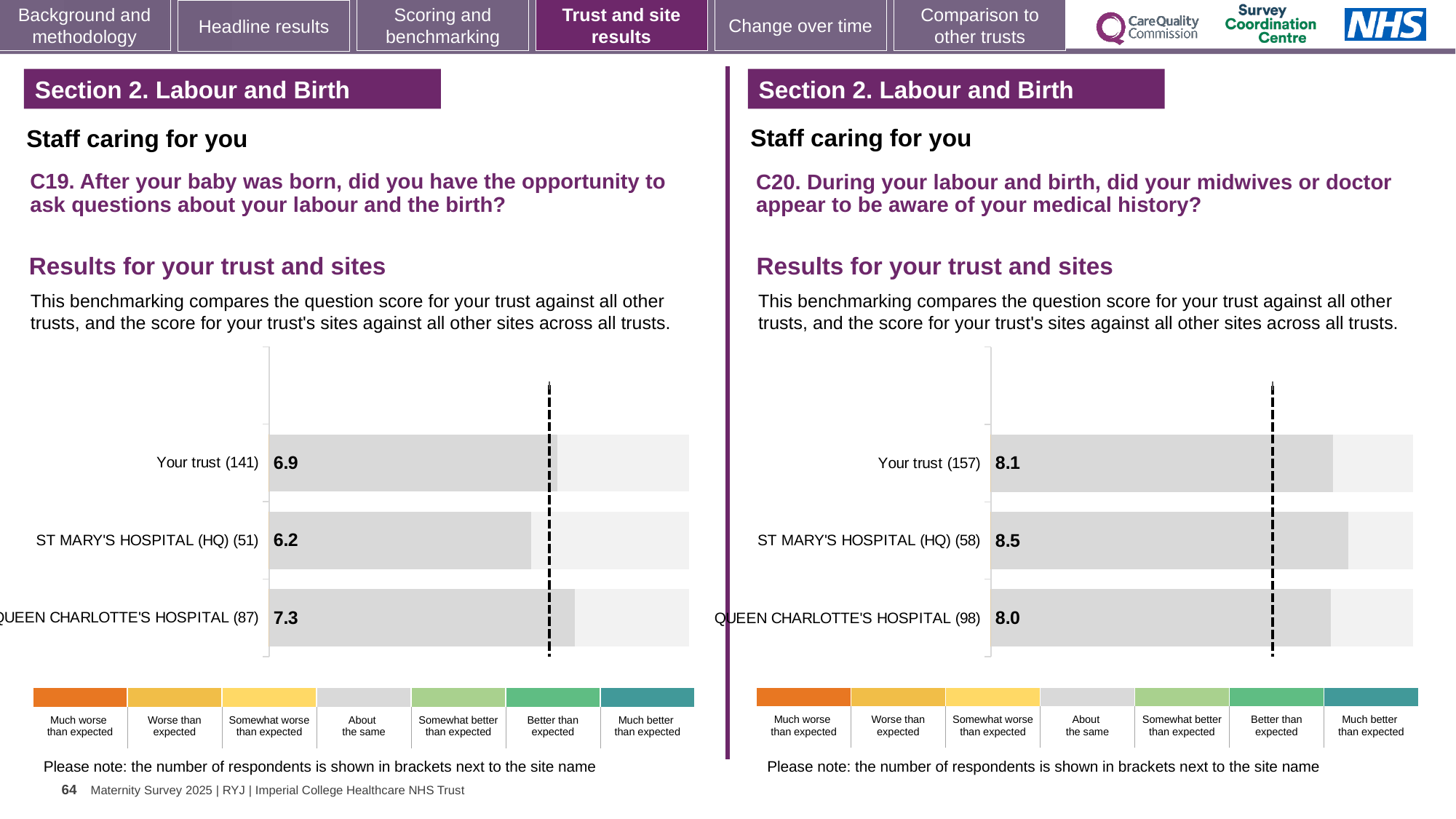
In the C19 chart on the left, which site or trust has the lowest score? ST MARY'S HOSPITAL (HQ) In the C20 chart on the right, what is the difference between the scores for ST MARY'S HOSPITAL (HQ) and Your trust? 0.4 In the C20 chart on the right, what is the score for QUEEN CHARLOTTE'S HOSPITAL? 8.0 In the C19 chart on the left, what is the score for ST MARY'S HOSPITAL (HQ)? 6.2 In the C20 chart on the right, which site or trust has the highest score? ST MARY'S HOSPITAL (HQ) In the C19 chart on the left, what is the score for Your trust? 6.9 In the C20 chart on the right, what is the score for ST MARY'S HOSPITAL (HQ)? 8.5 In the C19 chart on the left, what is the difference between the scores for QUEEN CHARLOTTE'S HOSPITAL and ST MARY'S HOSPITAL (HQ)? 1.1 What type of chart is used in the C20 chart on the right? Bar chart Which is larger: the score for Your trust in the C19 chart on the left or the score for Your trust in the C20 chart on the right? C20 chart (8.1) How many bars are shown in the C19 chart on the left? 3 In the C19 chart on the left, which site or trust has the highest score? QUEEN CHARLOTTE'S HOSPITAL